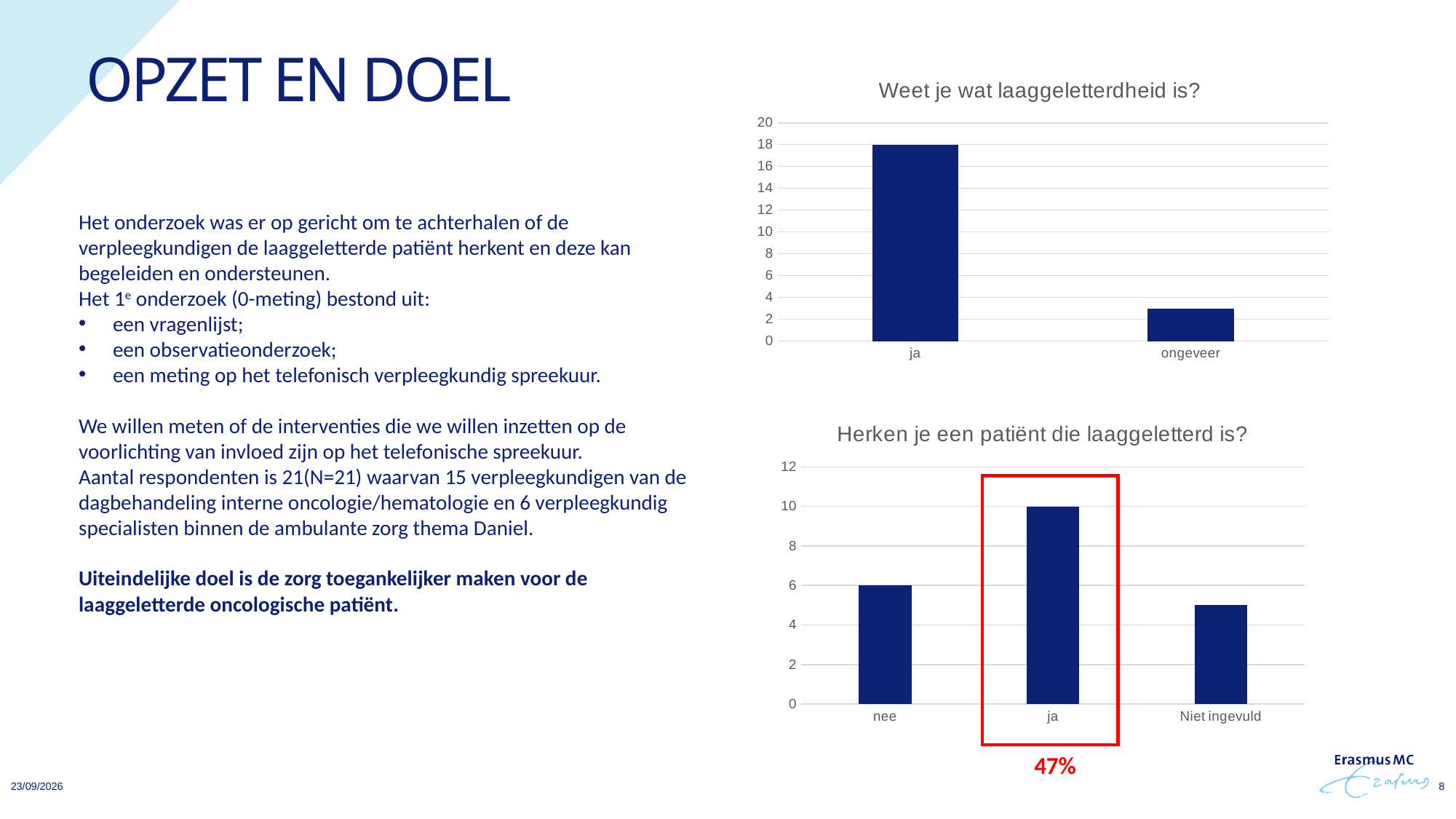
In the chart 'Herken je een patiënt die laaggeletterd is?', which category has the highest value? ja In the chart 'Herken je een patiënt die laaggeletterd is?', what is the difference between the values for 'ja' and 'nee'? 4 In the chart 'Herken je een patiënt die laaggeletterd is?', what is the value for 'ja'? 10 In the chart 'Weet je wat laaggeletterdheid is?', which category has the highest value? ja How many categories are shown in the chart 'Weet je wat laaggeletterdheid is?'? 2 In the chart 'Herken je een patiënt die laaggeletterd is?', is the value for 'Niet ingevuld' greater or less than 4? greater In the chart 'Weet je wat laaggeletterdheid is?', what is the value for 'ja'? 18 In the chart 'Herken je een patiënt die laaggeletterd is?', what percentage is written in red below the highlighted 'ja' bar? 47% In the chart 'Weet je wat laaggeletterdheid is?', is the value for 'ongeveer' greater or less than 4? less In the chart 'Herken je een patiënt die laaggeletterd is?', what is the value for 'nee'? 6 How many categories are shown in the chart 'Herken je een patiënt die laaggeletterd is?'? 3 What type of chart is 'Weet je wat laaggeletterdheid is?'? bar chart